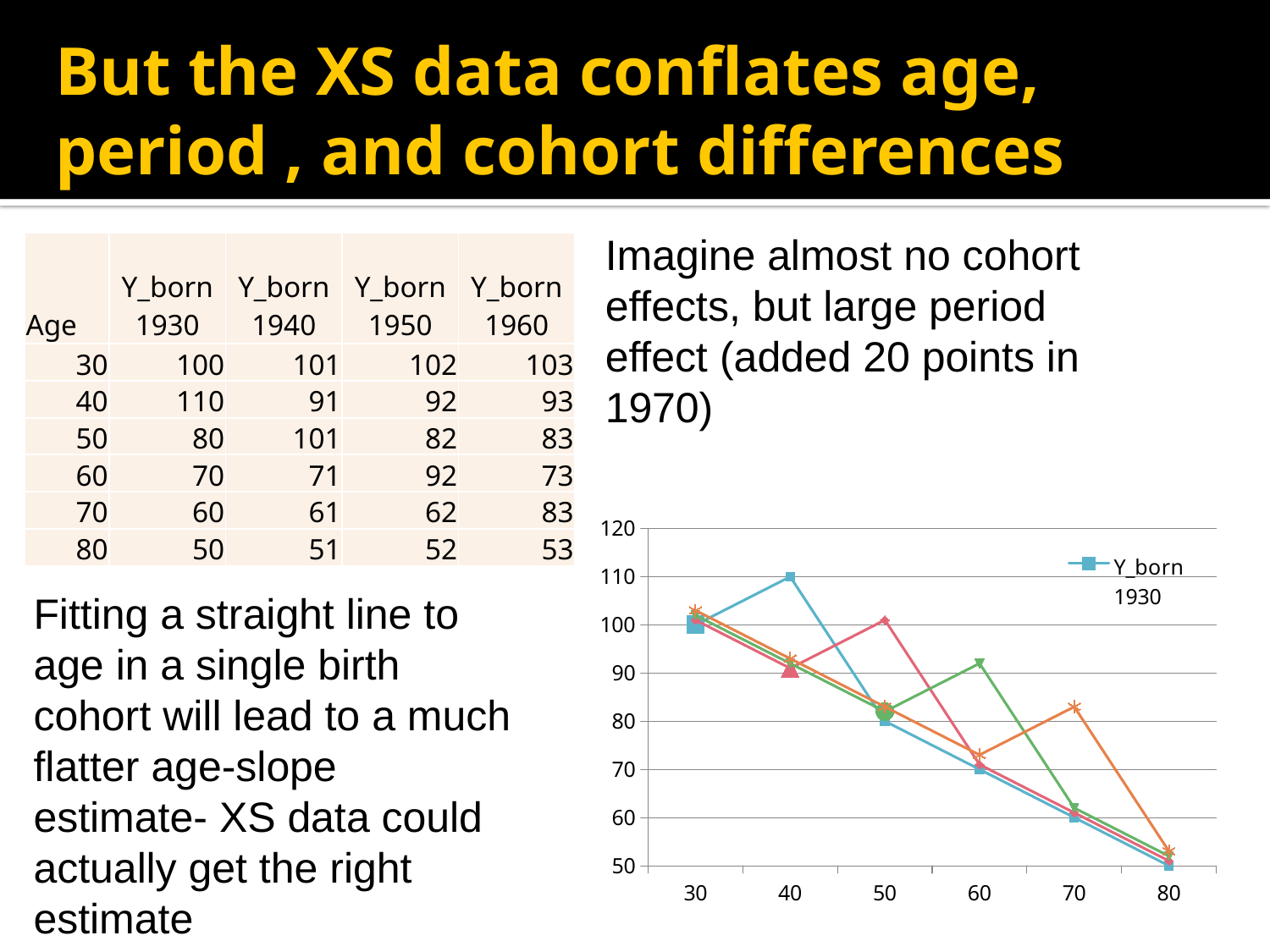
In the chart, what is the value of the Y_born 1930 series at age 30? 100 What is the lowest value shown on the chart's y axis? 50 In the chart, what is the difference between the Y_born 1930 values at age 40 and age 80? 60 In the chart, what is the value of the Y_born 1930 series at age 40? 110 In the chart, is the value of the Y_born 1930 series at age 50 greater or less than 90? less In the chart, does the Y_born 1930 series rise or fall from age 40 to age 80? fall What kind of chart is shown on the slide? line chart In the chart, what is the value of the Y_born 1930 series at age 80? 50 In the chart, at which age does the Y_born 1930 series reach its lowest value? 80 In the chart, at which age does the Y_born 1930 series reach its highest value? 40 In the chart, which is larger for the Y_born 1930 series: the value at age 30 or at age 40? age 40 How many age categories are shown on the x axis of the chart? 6